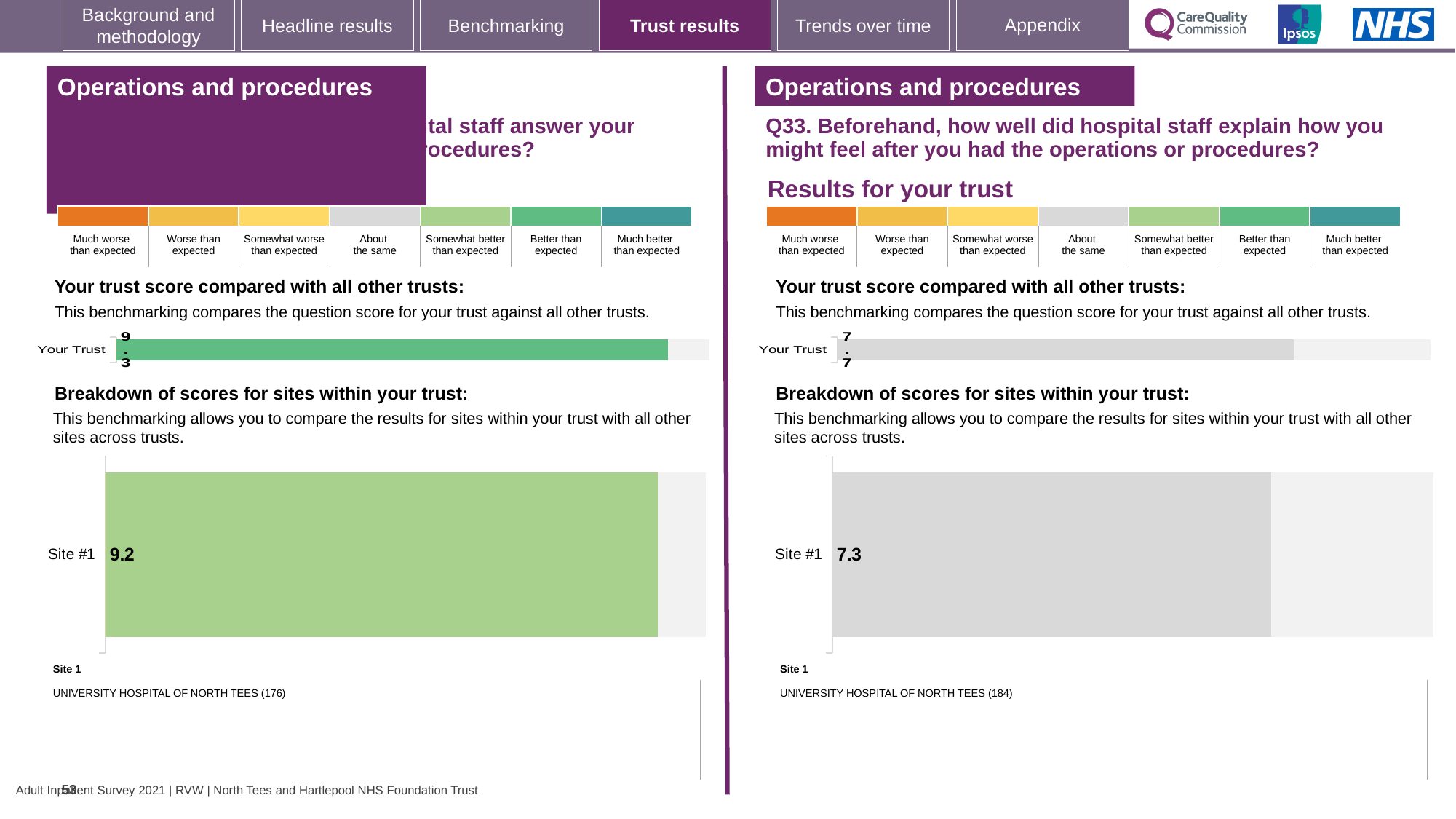
What type of chart is used to show the Site #1 score on the left-hand panel? Bar chart On the right-hand panel (Q33), which is larger: the Your Trust score or the Site #1 score? Your Trust How many categories does the colour scale above the charts on the right-hand panel (Q33) contain, from 'Much worse than expected' to 'Much better than expected'? 7 How many sites are shown in the 'Breakdown of scores for sites within your trust' chart on the right-hand panel (Q33)? 1 On the right-hand panel (Q33), which site is listed as Site 1 below the breakdown chart? UNIVERSITY HOSPITAL OF NORTH TEES (184) On the left-hand panel, what is the difference between the Your Trust score and the Site #1 score? 0.1 On the right-hand panel (Q33), what is the difference between the Your Trust score and the Site #1 score? 0.4 On the left-hand panel, what is the score shown for Your Trust in the 'Your trust score compared with all other trusts' chart? 9.3 On the right-hand panel (Q33), what is the score shown for Site #1 in the 'Breakdown of scores for sites within your trust' chart? 7.3 Which panel shows the higher Site #1 score, the left-hand panel or the right-hand panel (Q33)? Left-hand panel On the left-hand panel, what is the score shown for Site #1 in the 'Breakdown of scores for sites within your trust' chart? 9.2 On the right-hand panel (Q33), what is the score shown for Your Trust in the 'Your trust score compared with all other trusts' chart? 7.7